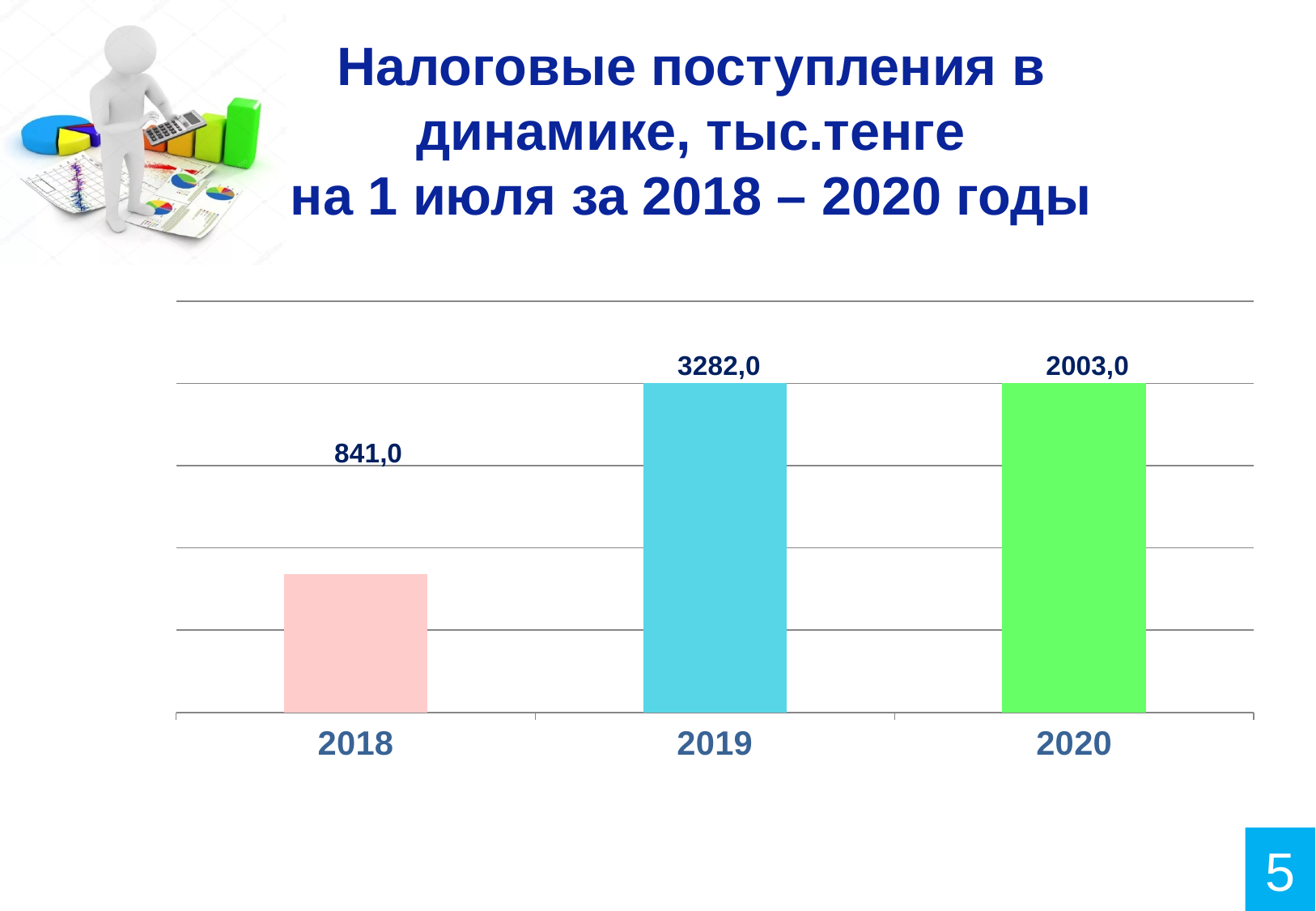
How many years are shown on the chart? 3 What is the difference between the values for 2020 and 2018? 1162,0 Which year has the lowest value? 2018 What is the value for 2018? 841,0 What is the value for 2019? 3282,0 What kind of chart is shown on the slide? Bar chart What unit is given in the chart title? тыс.тенге Which year has the highest value? 2019 What is the difference between the values for 2019 and 2018? 2441,0 What is the value for 2020? 2003,0 Which is larger, the value for 2018 or the value for 2020? 2020